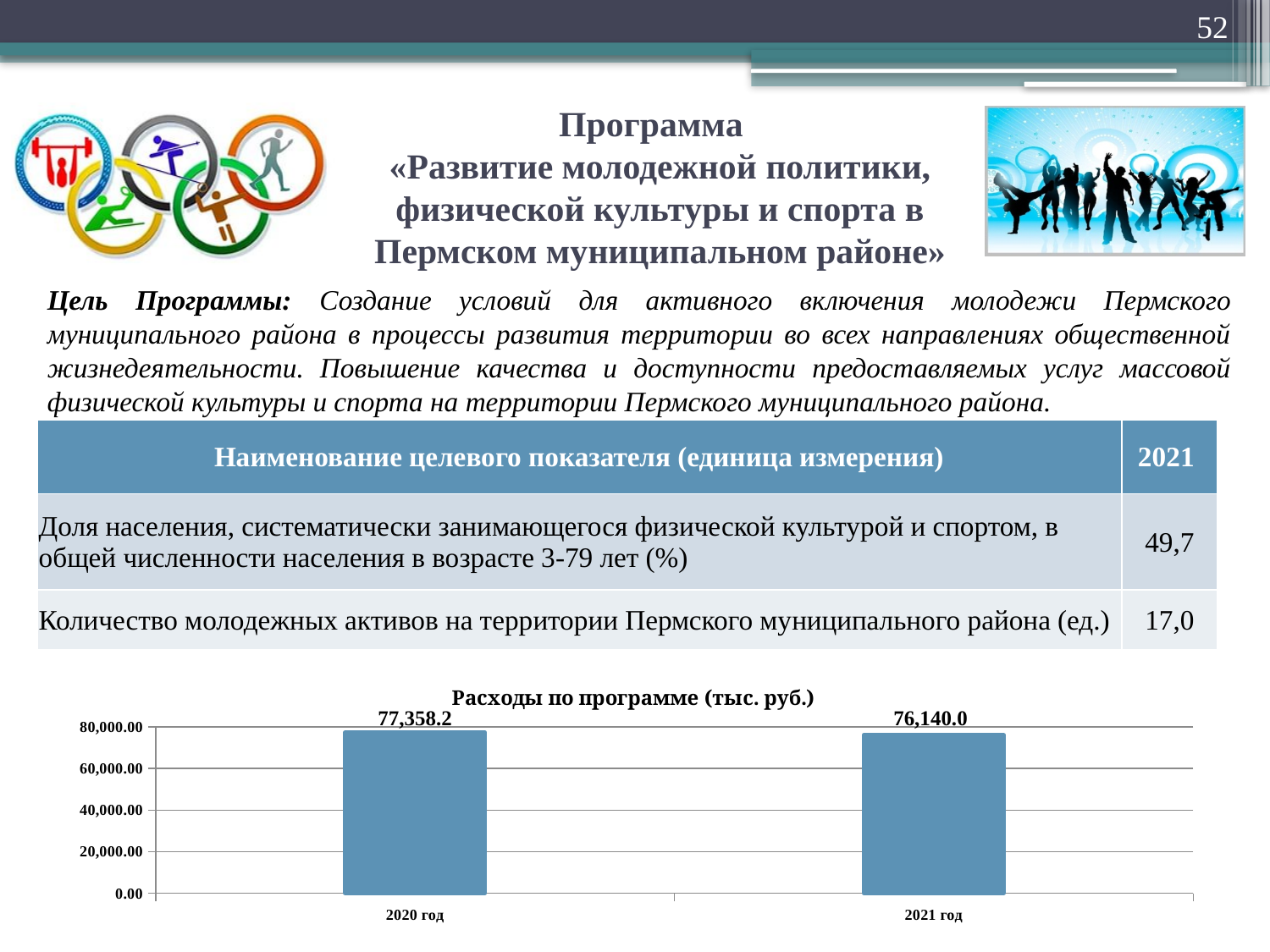
What is the title of the chart at the bottom of the slide? Расходы по программе (тыс. руб.) What is the difference between the 2020 год and 2021 год values in the chart 'Расходы по программе (тыс. руб.)'? 1,218.2 What kind of chart is 'Расходы по программе (тыс. руб.)'? bar chart What is the value for 2020 год in the chart 'Расходы по программе (тыс. руб.)'? 77,358.2 How many categories are shown on the x axis of the chart 'Расходы по программе (тыс. руб.)'? 2 Which year has the lower expenditure in the chart 'Расходы по программе (тыс. руб.)'? 2021 год Is the value for 2020 год greater or less than 80,000.00 in the chart 'Расходы по программе (тыс. руб.)'? less Which year has the higher expenditure in the chart 'Расходы по программе (тыс. руб.)'? 2020 год What is the value for 2021 год in the chart 'Расходы по программе (тыс. руб.)'? 76,140.0 Is the value for 2021 год greater or less than 60,000.00 in the chart 'Расходы по программе (тыс. руб.)'? greater Is the value for 2020 год larger or smaller than the value for 2021 год in the chart 'Расходы по программе (тыс. руб.)'? larger Do the values rise or fall from 2020 год to 2021 год in the chart 'Расходы по программе (тыс. руб.)'? fall